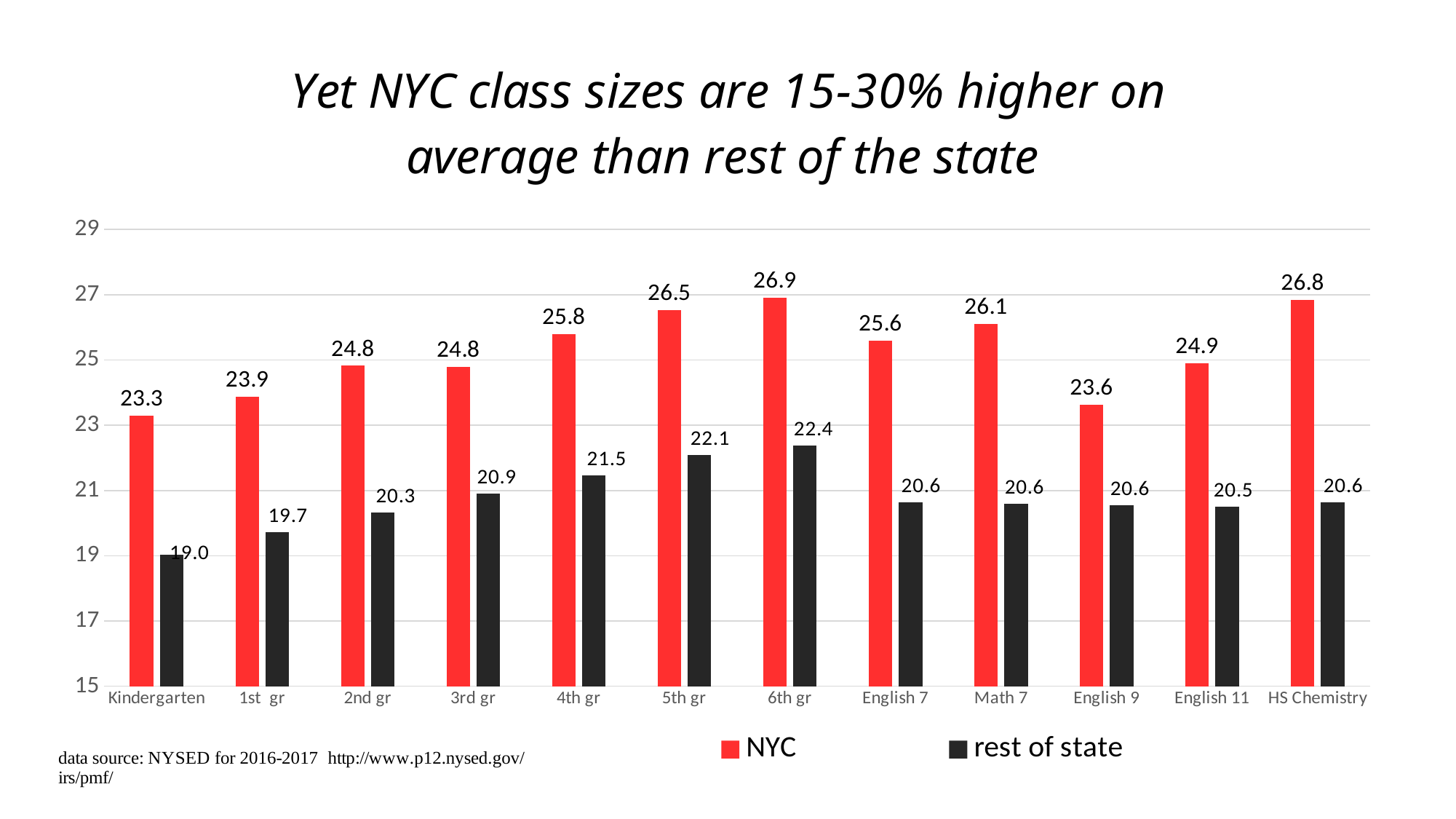
What is the NYC class size for 6th gr? 26.9 Which category has the lowest rest of state class size? Kindergarten Is the rest of state class size for 5th gr greater or less than 21? greater Which category has the highest NYC class size? 6th gr What kind of chart is shown on the slide? bar chart How many categories are shown on the x axis? 12 What colour are the NYC bars? red How many series does the legend list? 2 What is the difference between the NYC and rest of state class sizes for 4th gr? 4.3 What is the rest of state class size for Kindergarten? 19.0 Which is larger, the NYC class size for English 9 or for English 11? English 11 What is the NYC class size for HS Chemistry? 26.8